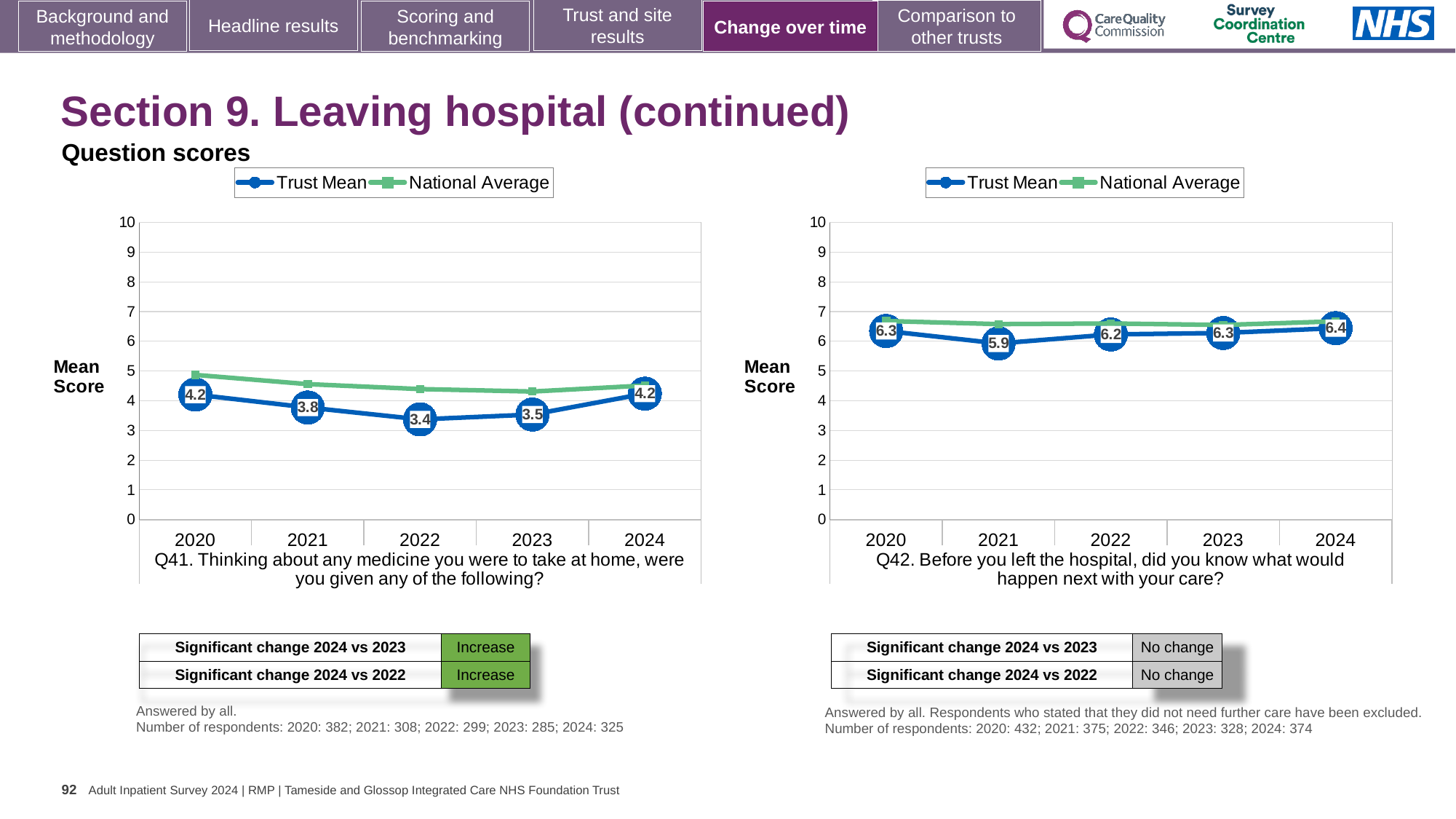
In the Q42 chart on the right, which year has the lowest Trust Mean score? 2021 In the Q41 chart on the left, what is the Trust Mean score for 2022? 3.4 In the Q41 chart on the left, what is the Trust Mean score for 2024? 4.2 In the Q42 chart on the right, what is the Trust Mean score for 2024? 6.4 How many series does the legend of the Q42 chart on the right list? 2 What type of chart is the Q41 chart on the left? Line chart In the Q41 chart on the left, which year has the lowest Trust Mean score? 2022 In the Q42 chart on the right, what is the Trust Mean score for 2021? 5.9 In the Q42 chart on the right, which year has the highest Trust Mean score? 2024 In the Q41 chart on the left, what is the difference between the Trust Mean scores for 2024 and 2023? 0.7 In the Q41 chart on the left, is the National Average value for 2020 greater or less than 4? greater In the Q42 chart on the right, is the Trust Mean for 2021 larger or smaller than the Trust Mean for 2023? smaller